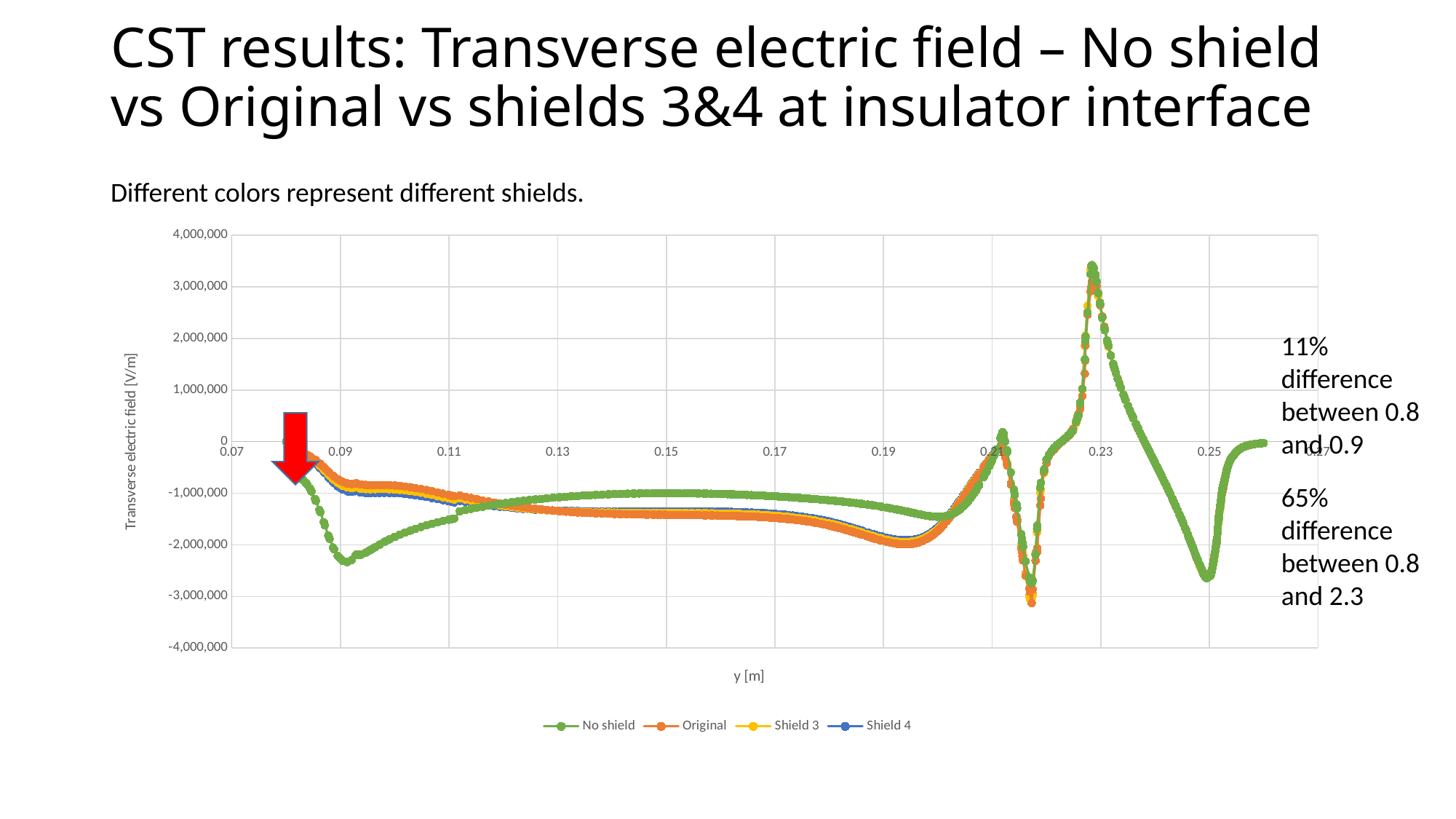
Which series reaches the lowest value in the region between y = 0.07 and y = 0.11? No shield What kind of chart is shown on the slide? line chart Is the value of the curves at the dip near y = 0.25 greater or less than -2,000,000? less What is the label of the x axis? y [m] At y = 0.15, is the No shield series greater or less than -2,000,000? greater Is the peak value of the curves near y = 0.23 greater or less than 3,000,000? greater How many series does the legend list? 4 At y = 0.15, which series has the higher value, No shield or Original? No shield At y = 0.09, which series has the lower value, No shield or Original? No shield What are the series names listed in the legend? No shield, Original, Shield 3, Shield 4